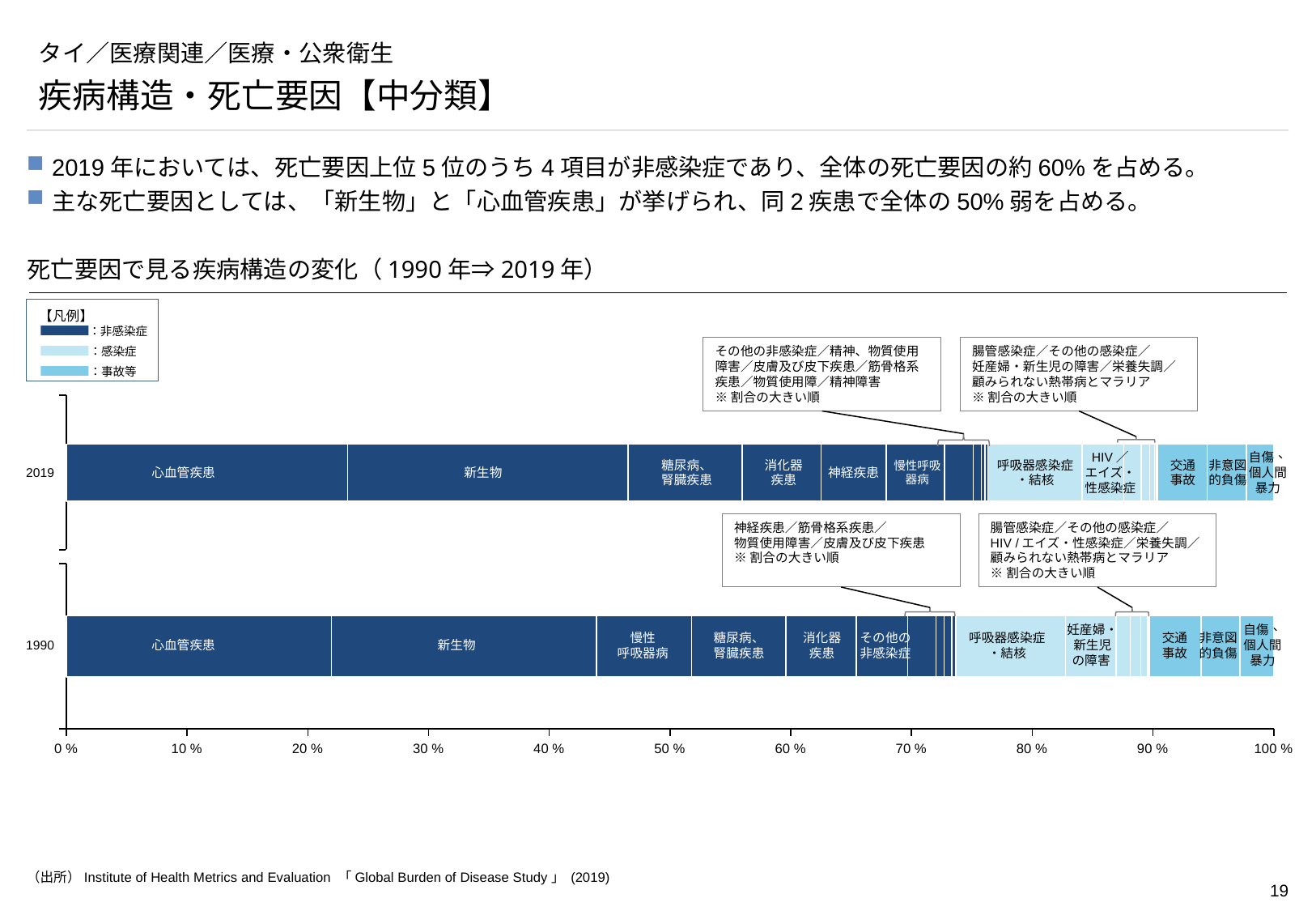
What kind of chart is shown on the slide? Stacked bar chart Which years are compared in the chart? 1990 and 2019 How many entries does the legend (凡例) list? 3 Which category is the leftmost segment of the 2019 bar? 心血管疾患 Is the share of 新生物 in 2019 greater or less than 20%? greater Is the share of 心血管疾患 in 2019 greater or less than 20%? greater Is the share of 慢性呼吸器病 in 2019 greater or less than 10%? less In the 1990 bar, which is larger: 新生物 or 慢性呼吸器病? 新生物 In the 2019 bar, which is larger: 呼吸器感染症・結核 or 交通事故? 呼吸器感染症・結核 How many years (bars) are plotted in the chart? 2 In the 2019 bar, which is larger: 糖尿病、腎臓疾患 or 消化器疾患? 糖尿病、腎臓疾患